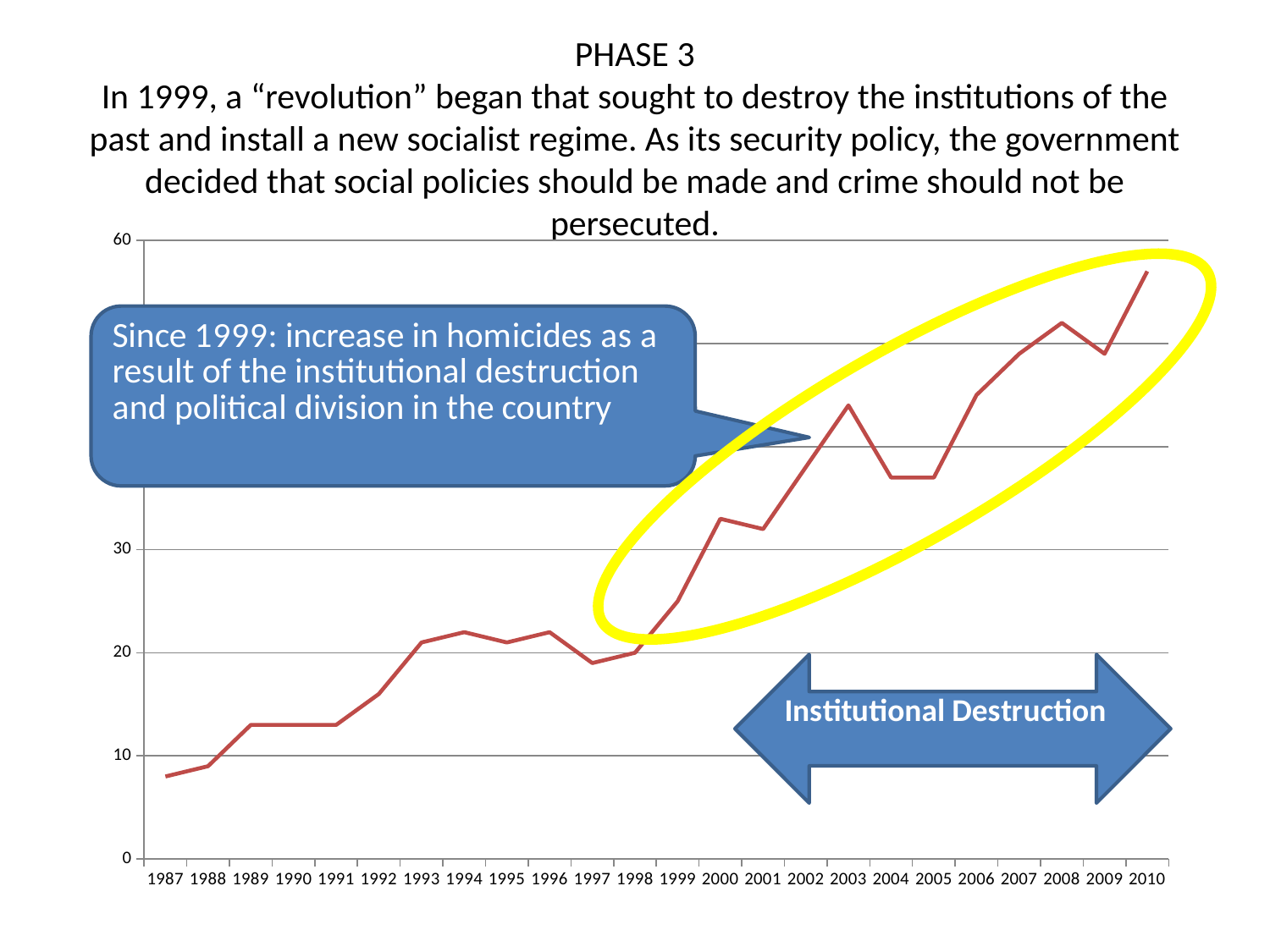
Is the value for 1987 greater or less than 10? less What kind of chart is shown on the slide? line chart How many years are plotted along the x axis of the chart? 24 Is the value for 2000 greater or less than 30? greater What label is written inside the blue double-headed arrow on the chart? Institutional Destruction Which is larger, the value for 2003 or the value for 2004? 2003 Is the value for 1993 greater or less than 20? greater Which year has the highest value on the chart? 2010 Overall, do the values rise or fall from 1987 to 2010? rise Which year has the lowest value on the chart? 1987